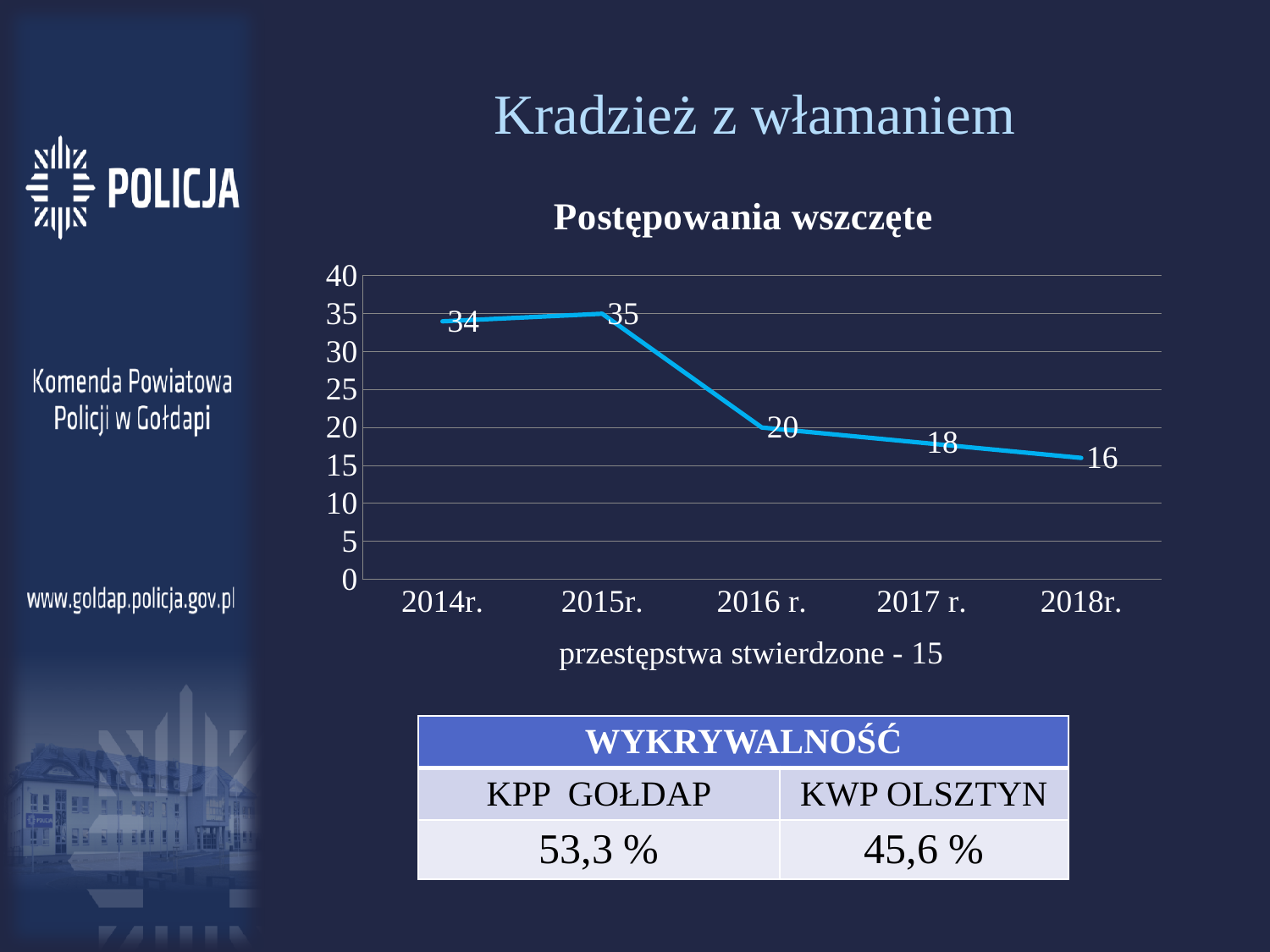
What is the difference between the values for 2015r. and 2016 r.? 15 Which year has the highest value in the chart? 2015r. How many years are plotted in the chart? 5 Which year has the lowest value in the chart? 2018r. What is the value for 2014r. in the chart? 34 Is the value for 2017 r. greater or less than 20? less Which is larger, the value for 2017 r. or the value for 2018r.? 2017 r. What is the value for 2018r. in the chart? 16 What is the value for 2016 r. in the chart? 20 What kind of chart is shown on the slide? line chart Do the values rise or fall from 2015r. to 2018r.? fall What is the difference between the values for 2014r. and 2018r.? 18